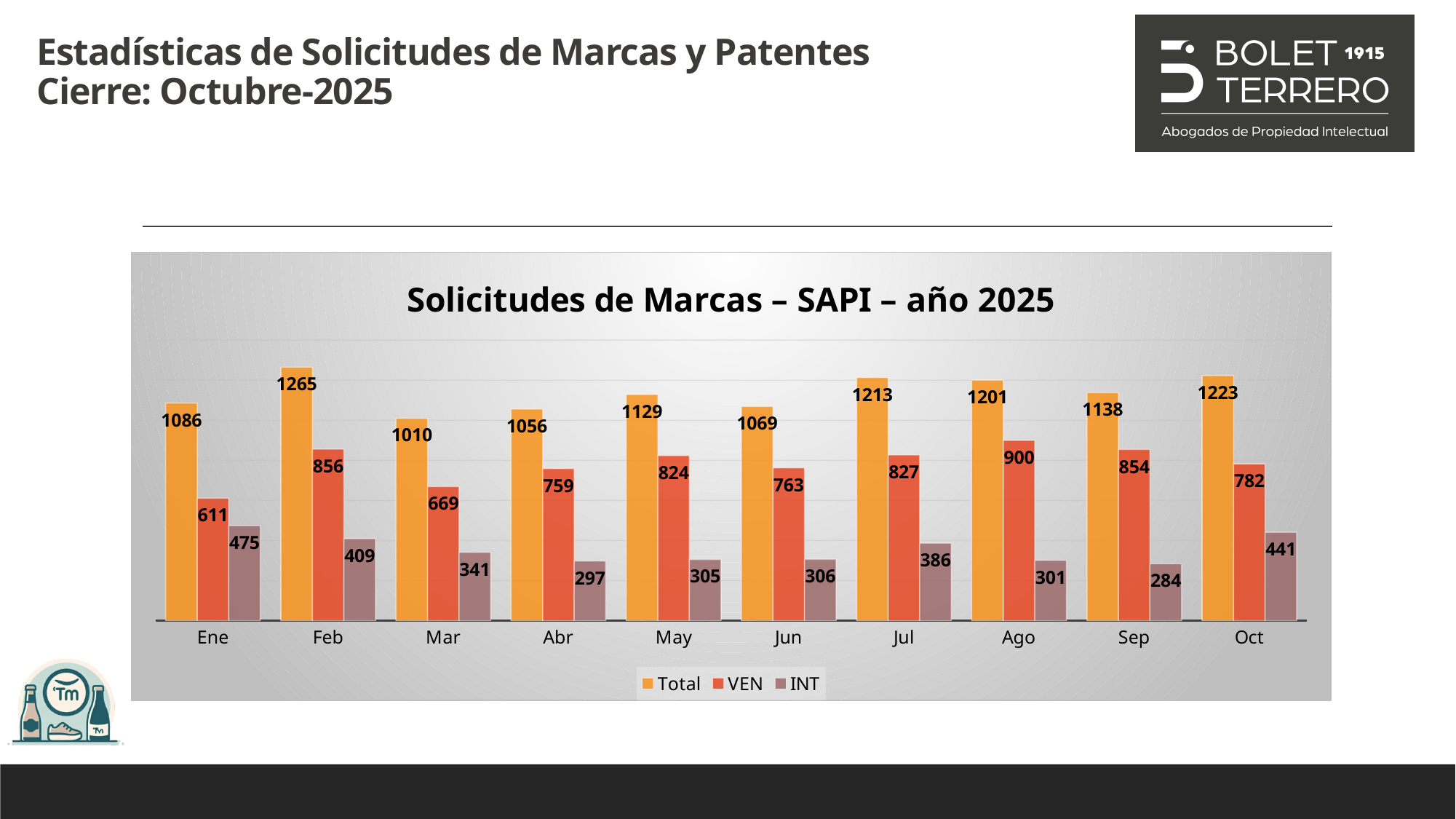
What is the INT value for Oct? 441 What kind of chart is shown? Bar chart What is the Total value for Feb? 1265 Which is larger, the VEN value for Jul or the VEN value for Sep? Sep Which month has the highest Total value? Feb How many series does the legend list? 3 What is the title of the chart? Solicitudes de Marcas – SAPI – año 2025 What is the difference between the Total values for Feb and Mar? 255 What is the VEN value for Ago? 900 How many months are shown on the x axis? 10 Which series is shown in orange-yellow bars? Total Which month has the lowest INT value? Sep